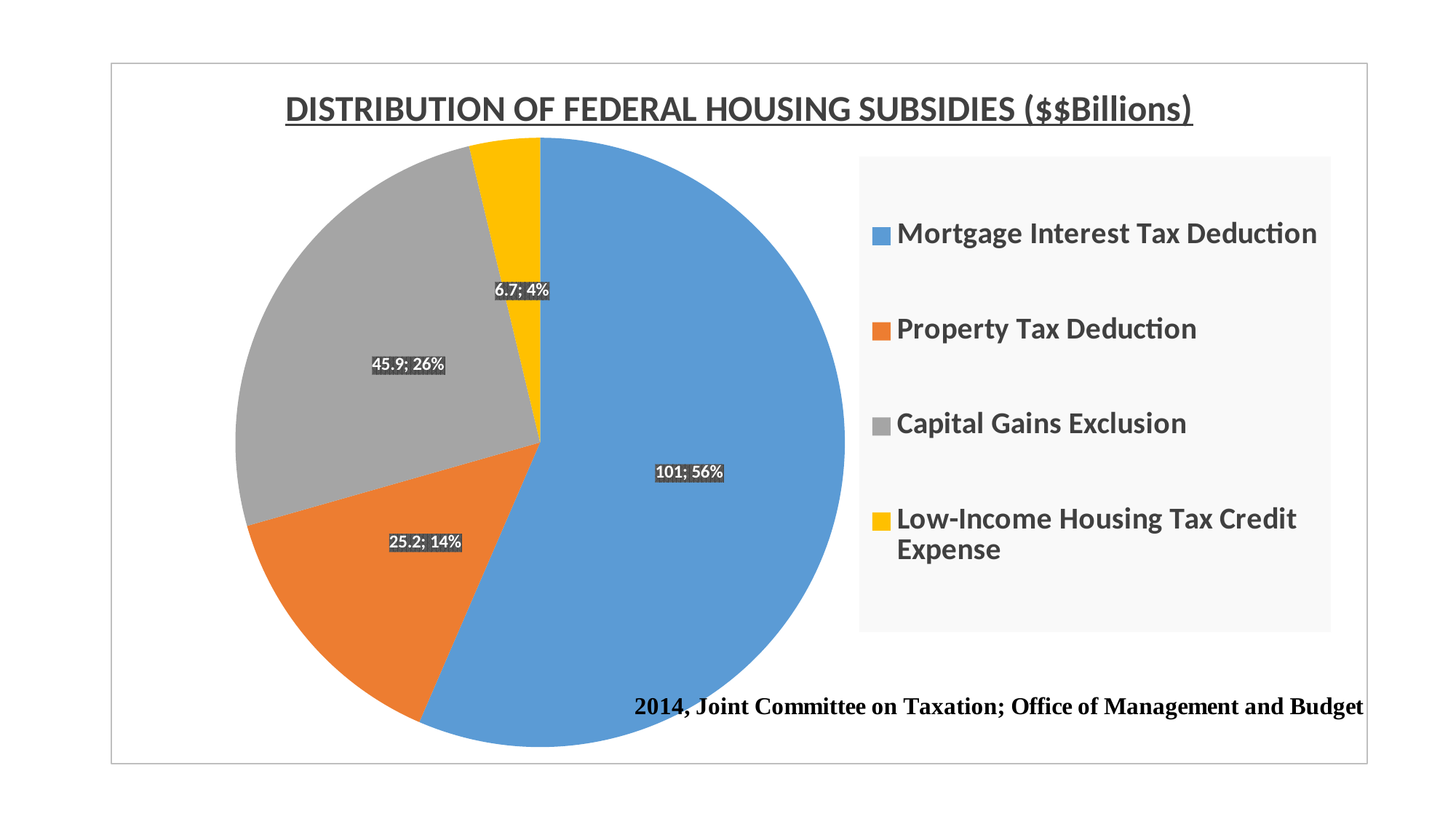
What is the value for Property Tax Deduction? 25.2 Which category has the smallest slice of the pie? Low-Income Housing Tax Credit Expense What kind of chart is shown on the slide? Pie chart What is the value for Mortgage Interest Tax Deduction? 101 What is the difference between the values for Mortgage Interest Tax Deduction and Capital Gains Exclusion? 55.1 What is the value for Capital Gains Exclusion? 45.9 What share of the pie does Property Tax Deduction represent? 14% Which category has the largest slice of the pie? Mortgage Interest Tax Deduction What is the value for Low-Income Housing Tax Credit Expense? 6.7 How many categories are shown in the pie chart? 4 Which is larger, the value for Property Tax Deduction or the value for Low-Income Housing Tax Credit Expense? Property Tax Deduction What share of the pie does Capital Gains Exclusion represent? 26%